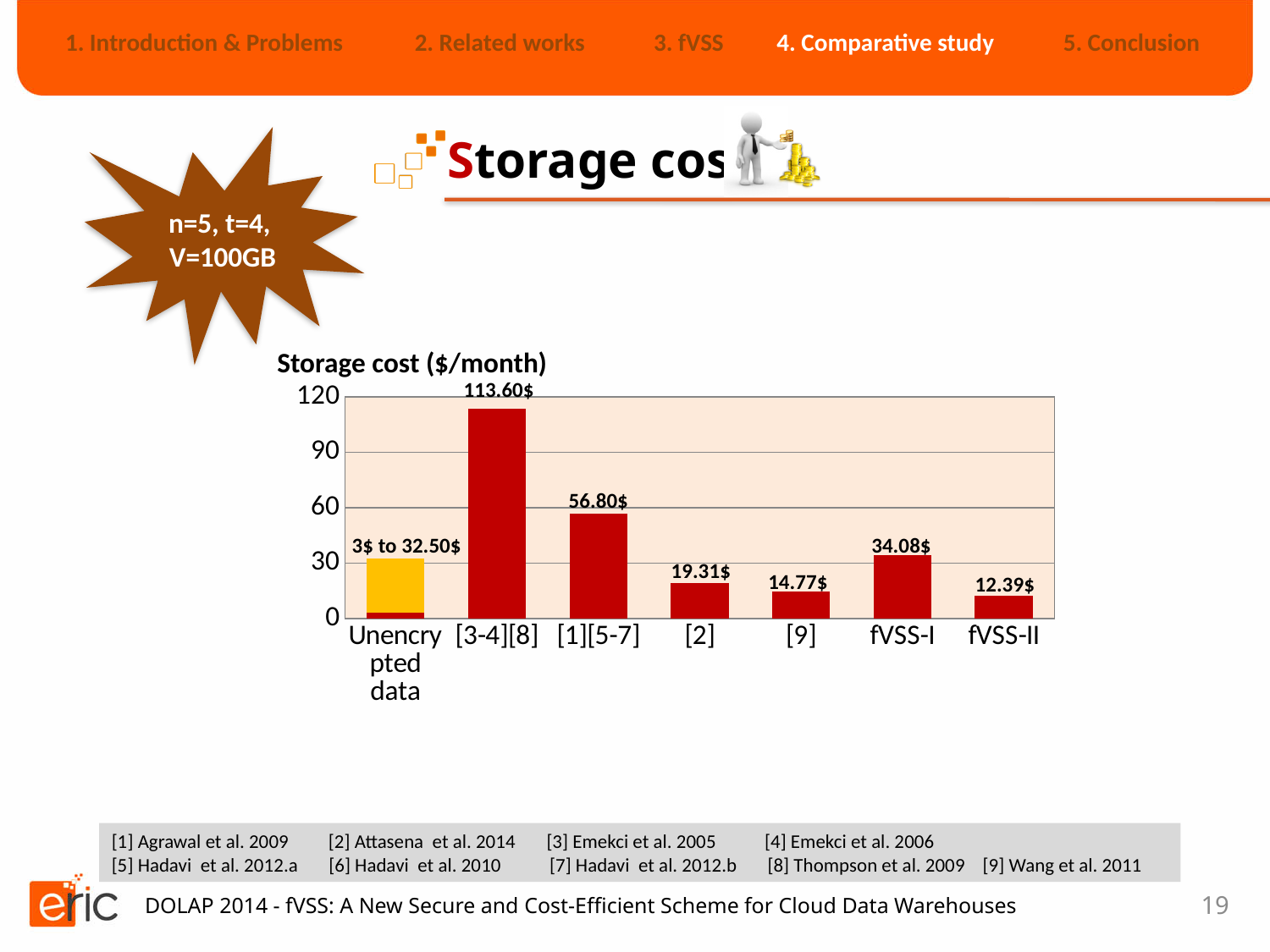
What is the storage cost for fVSS-II? 12.39$ What kind of chart is shown on the slide? Bar chart How many categories are shown on the x axis of the chart? 7 What is the difference in storage cost between [3-4][8] and [1][5-7]? 56.80$ What is the storage cost for [3-4][8]? 113.60$ Which category has the highest storage cost? [3-4][8] What is the storage cost for fVSS-I? 34.08$ Is the storage cost for fVSS-I greater or less than 30? greater Which has a higher storage cost, [2] or [9]? [2] What is the storage cost for [9]? 14.77$ What is the difference in storage cost between fVSS-I and fVSS-II? 21.69$ What range of storage cost is labelled for Unencrypted data? 3$ to 32.50$